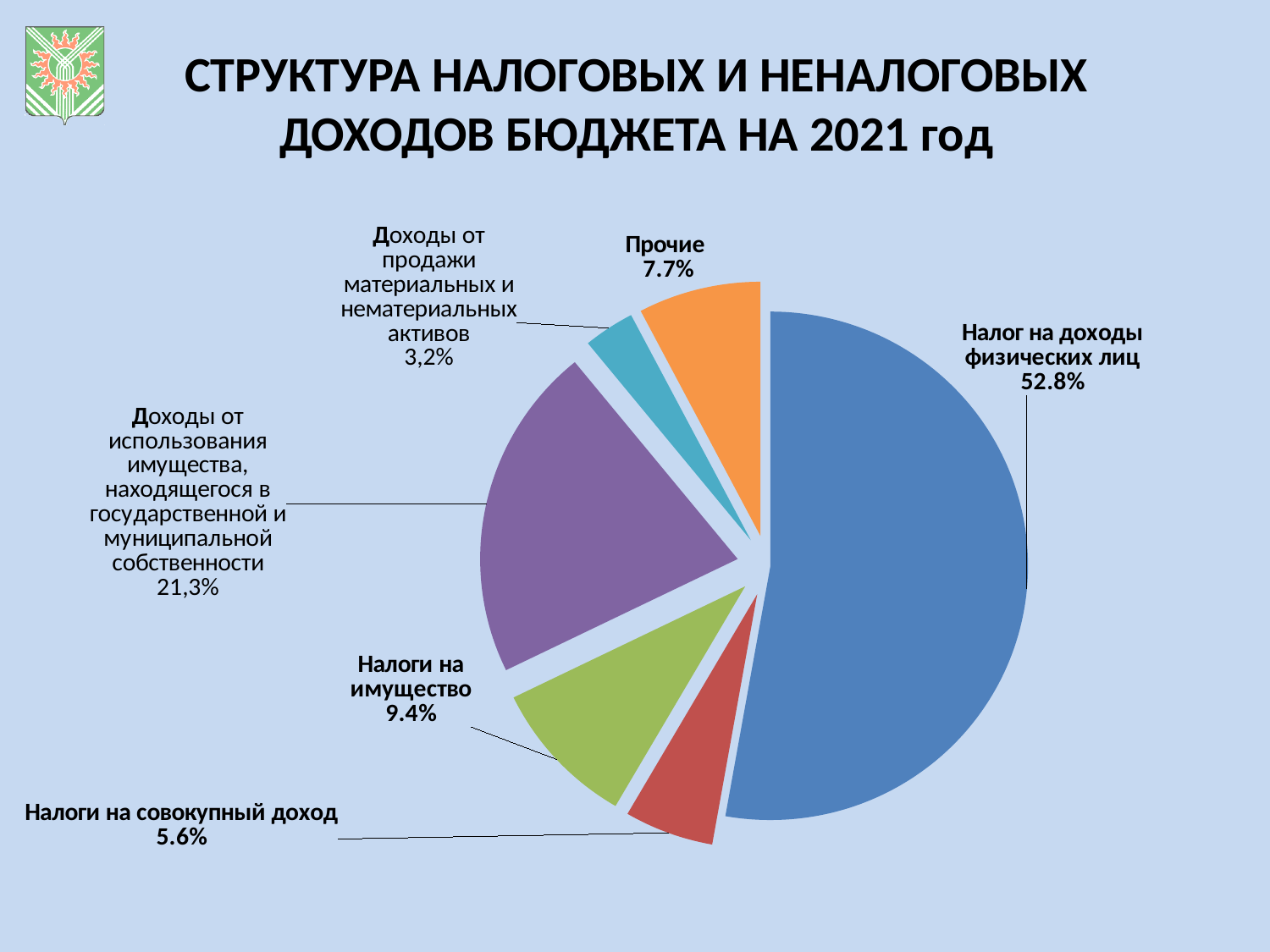
What kind of chart is shown on the slide? pie chart What is the value shown for "Налоги на совокупный доход"? 5.6% What is the difference between the shares of "Налоги на имущество" and "Налоги на совокупный доход"? 3.8% What is the value shown for "Налоги на имущество"? 9.4% Which is larger: "Налоги на имущество" or "Прочие"? Налоги на имущество Which slice of the pie is the largest? Налог на доходы физических лиц Which slice of the pie is the smallest? Доходы от продажи материальных и нематериальных активов What is the value shown for "Доходы от использования имущества, находящегося в государственной и муниципальной собственности"? 21,3% What share of the pie does "Налог на доходы физических лиц" have? 52.8% How many slices does the pie chart have? 6 What is the value shown for "Доходы от продажи материальных и нематериальных активов"? 3,2% What is the value shown for "Прочие"? 7.7%